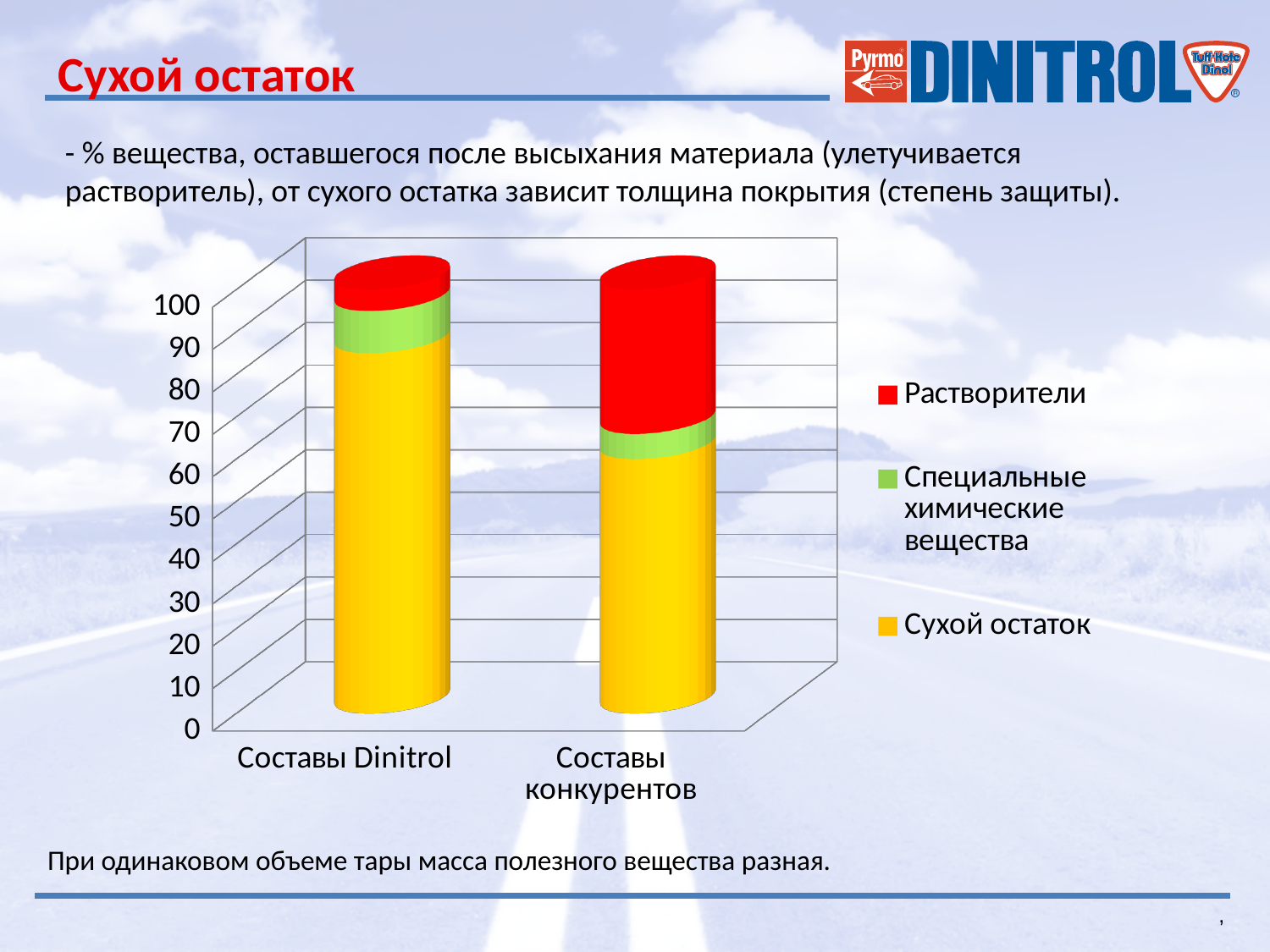
What kind of chart is shown on the slide? stacked bar chart How many series does the chart legend list? 3 Which category has the larger Сухой остаток value, Составы Dinitrol or Составы конкурентов? Составы Dinitrol How many categories are shown on the x axis of the chart? 2 Is the value of Сухой остаток for Составы конкурентов greater or less than 80? less Is the value of Сухой остаток for Составы конкурентов greater or less than 50? greater Which category has the larger Растворители value, Составы Dinitrol or Составы конкурентов? Составы конкурентов Which series is shown in red in the chart? Растворители Which category has the lowest Растворители value? Составы Dinitrol Which series is shown in yellow in the chart? Сухой остаток Which category has the highest Сухой остаток value? Составы Dinitrol Is the value of Сухой остаток for Составы Dinitrol greater or less than 80? greater